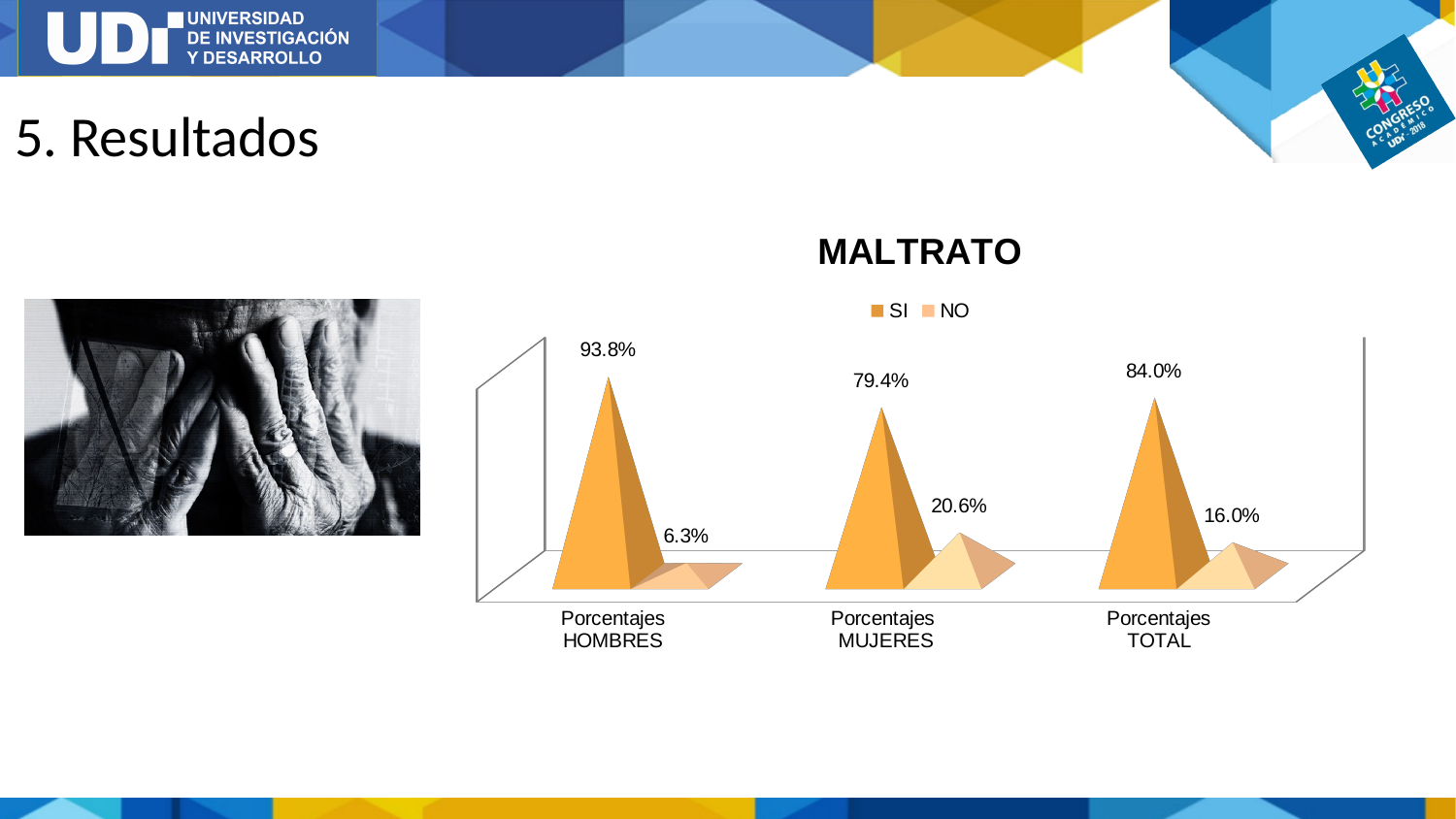
How many categories are shown on the x axis? 3 What are the series names listed in the legend? SI and NO What is the SI value for Porcentajes HOMBRES? 93.8% What is the NO value for Porcentajes HOMBRES? 6.3% What is the SI value for Porcentajes TOTAL? 84.0% What is the title of the chart? MALTRATO How many series does the legend list? 2 What is the difference between the SI values for Porcentajes HOMBRES and Porcentajes MUJERES? 14.4% What is the NO value for Porcentajes MUJERES? 20.6% Which is larger, the NO value for Porcentajes MUJERES or the NO value for Porcentajes TOTAL? Porcentajes MUJERES Which category has the highest SI value? Porcentajes HOMBRES Which category has the lowest NO value? Porcentajes HOMBRES